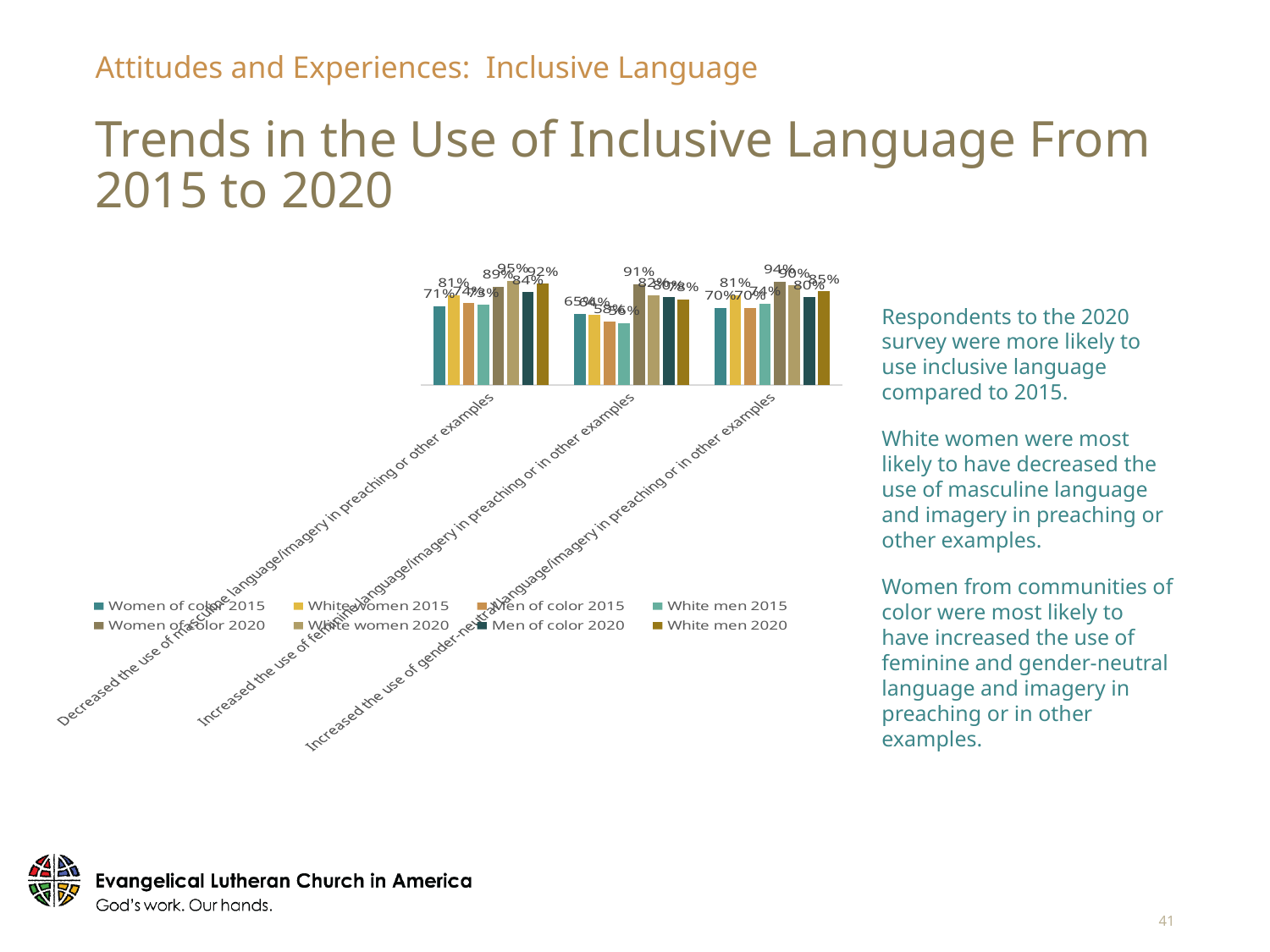
What is the value for Women of color 2015 in the 'Decreased the use of masculine language/imagery in preaching or other examples' category? 71% In the 'Decreased the use of masculine language/imagery in preaching or other examples' category, which is larger: Women of color 2015 or Women of color 2020? Women of color 2020 What kind of chart is shown on the slide? Bar chart How many categories are shown along the x axis of the chart? 3 Which series has the highest value in the 'Decreased the use of masculine language/imagery in preaching or other examples' category? White women 2020 How many series does the chart legend list? 8 What is the value for Women of color 2020 in the 'Increased the use of feminine language/imagery in preaching or in other examples' category? 91% What is the title of the chart's slide? Trends in the Use of Inclusive Language From 2015 to 2020 Which series has the highest value in the 'Increased the use of feminine language/imagery in preaching or in other examples' category? Women of color 2020 In the 'Decreased the use of masculine language/imagery in preaching or other examples' category, what is the difference between White women 2020 and Women of color 2015? 24 percentage points What is the value for White women 2020 in the 'Decreased the use of masculine language/imagery in preaching or other examples' category? 95% What is the value for Women of color 2020 in the 'Increased the use of gender-neutral language/imagery in preaching or in other examples' category? 94%